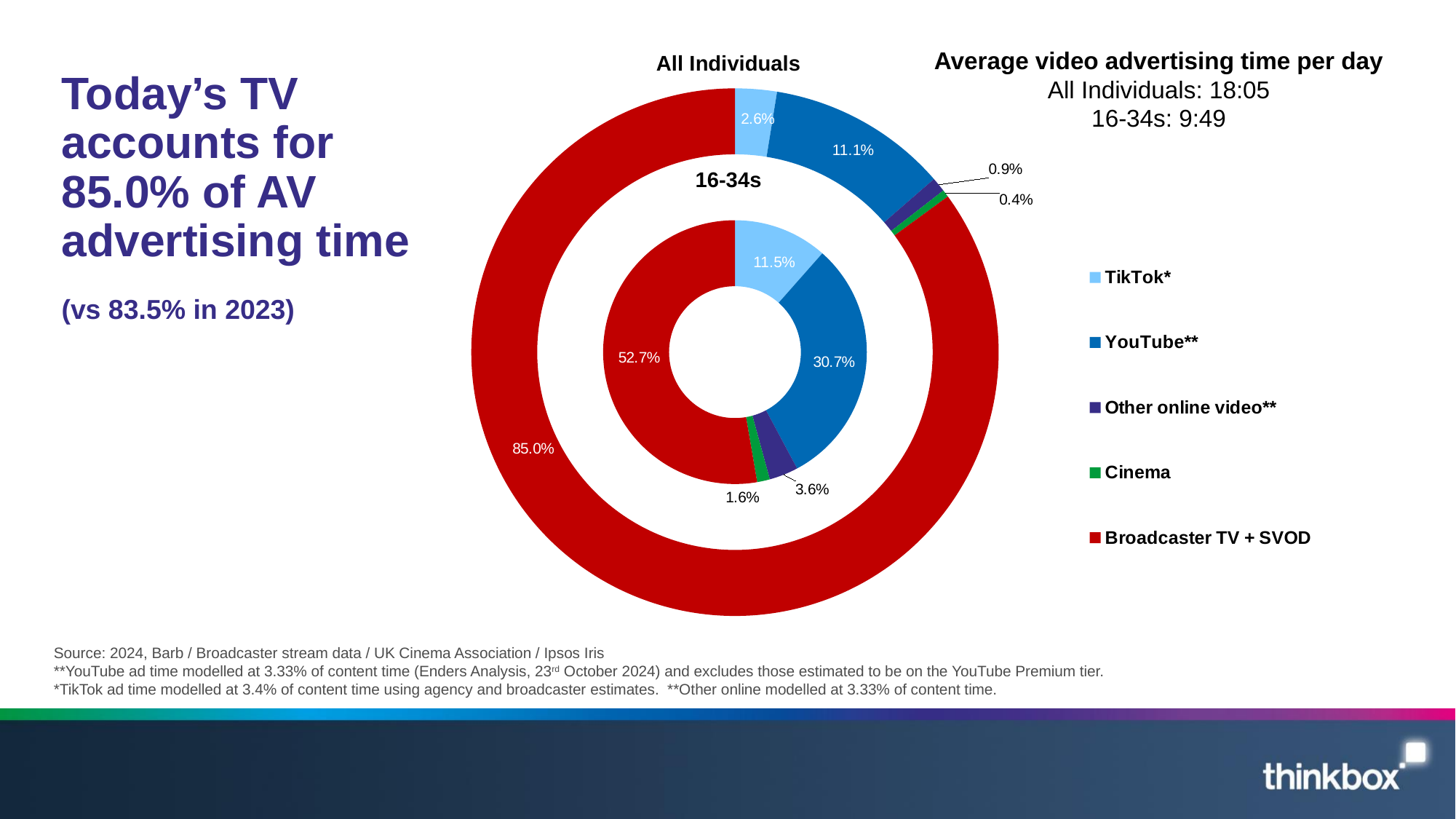
In the 16-34s ring, which is larger: the TikTok* share or the Other online video** share? TikTok* How many categories does the legend list? 5 What is the Cinema share in the 16-34s ring? 1.6% What share of AV advertising time does Broadcaster TV + SVOD account for in the All Individuals ring? 85.0% How much larger is the YouTube** share for 16-34s than for All Individuals? 19.6% What share does YouTube** have in the 16-34s ring? 30.7% What is the TikTok* share in the All Individuals ring? 2.6% Which category has the smallest share in the All Individuals ring? Cinema What kind of chart is shown on the slide? Doughnut chart Which category has the largest share in the 16-34s ring? Broadcaster TV + SVOD What is the difference between the Broadcaster TV + SVOD share for All Individuals and for 16-34s? 32.3% What colour represents Broadcaster TV + SVOD in the chart? Red